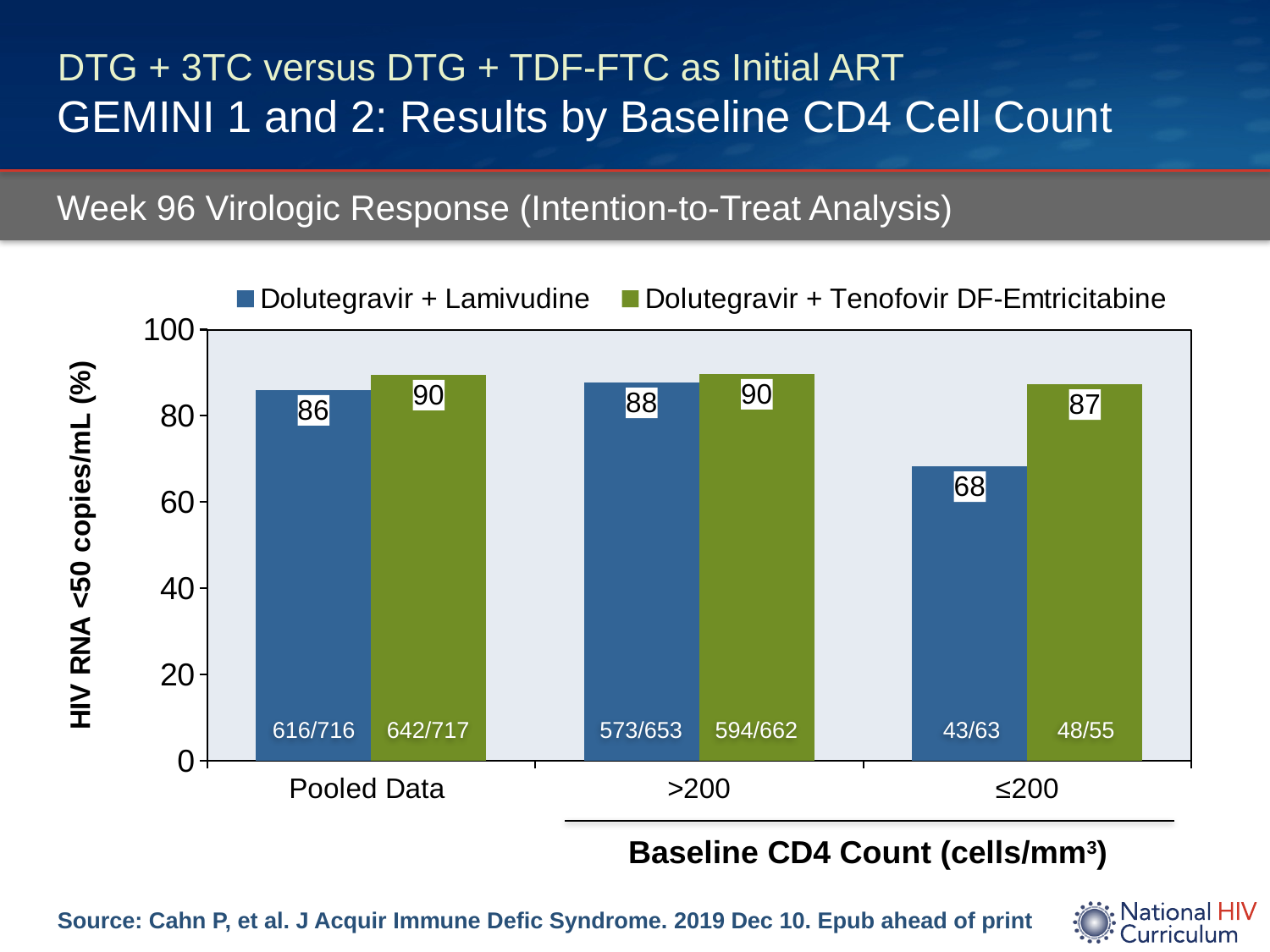
How many series does the legend list? 2 What is the difference between the Dolutegravir + Tenofovir DF-Emtricitabine and Dolutegravir + Lamivudine values in the ≤200 category? 19 What kind of chart is shown on the slide? bar chart How many categories are shown on the x axis? 3 In the >200 category, which series has the larger value? Dolutegravir + Tenofovir DF-Emtricitabine What is the fraction shown at the base of the Dolutegravir + Lamivudine bar in the ≤200 category? 43/63 What is the value for Dolutegravir + Lamivudine in the >200 baseline CD4 count category? 88 Is the value for Dolutegravir + Lamivudine in the ≤200 category greater or less than 80? less What is the value for Dolutegravir + Tenofovir DF-Emtricitabine in the ≤200 baseline CD4 count category? 87 Which category has the lowest value for Dolutegravir + Lamivudine? ≤200 What is the difference between the two series in the Pooled Data category? 4 What is the value for Dolutegravir + Lamivudine in the Pooled Data category? 86